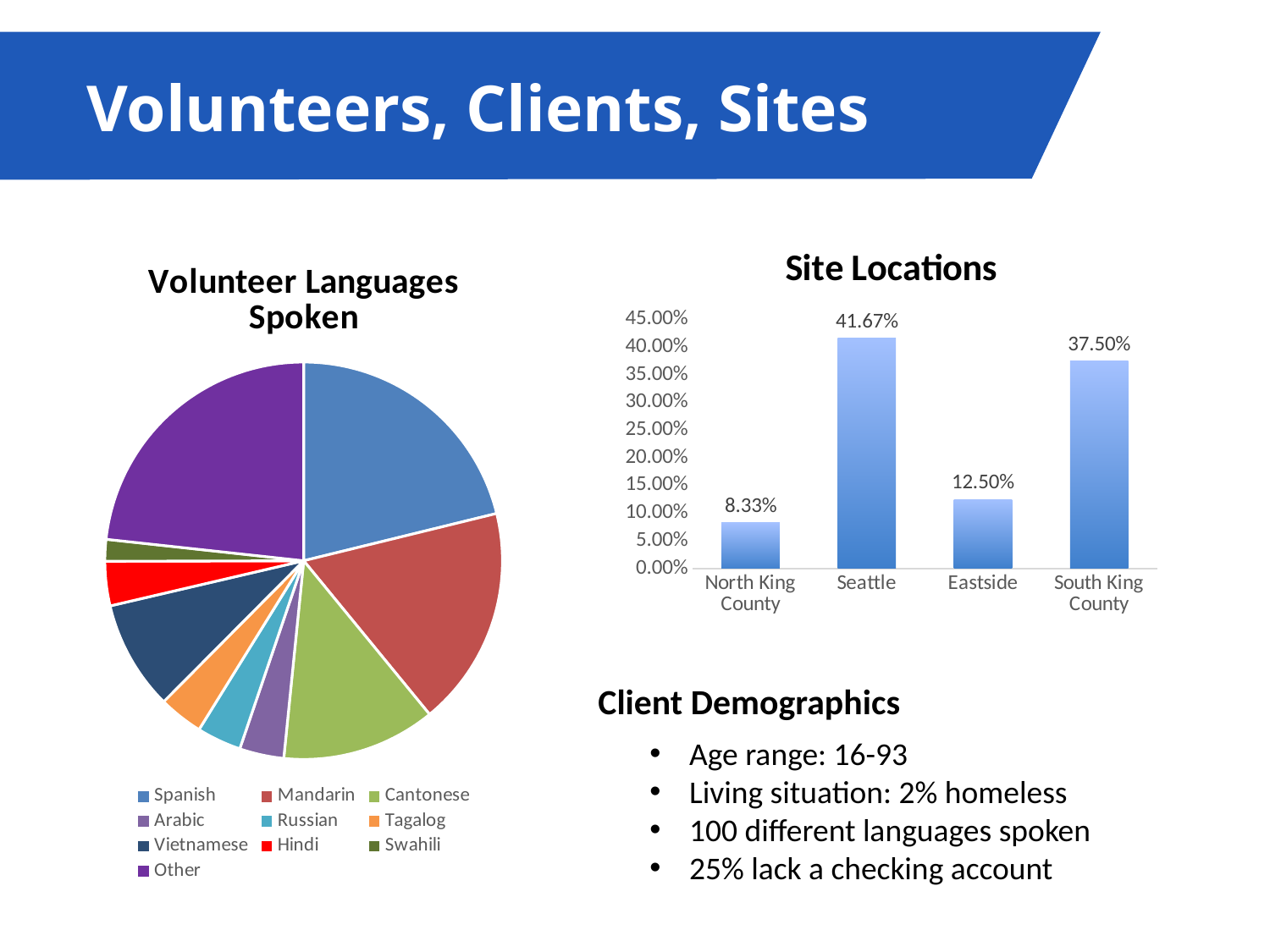
How many entries does the legend of the Volunteer Languages Spoken chart list? 10 What kind of chart is the Site Locations chart? Bar chart In the Site Locations chart, what is the value for Seattle? 41.67% In the Site Locations chart, which is larger, the value for Eastside or the value for North King County? Eastside In the Site Locations chart, which location has the highest value? Seattle In the Site Locations chart, what is the value for Eastside? 12.50% In the Site Locations chart, how many locations are shown? 4 In the Volunteer Languages Spoken pie chart, which slice is larger, Spanish or Swahili? Spanish In the Site Locations chart, which location has the lowest value? North King County In the Site Locations chart, what is the value for South King County? 37.50% In the Site Locations chart, what is the value for North King County? 8.33% In the Site Locations chart, what is the difference between the values for Seattle and South King County? 4.17%